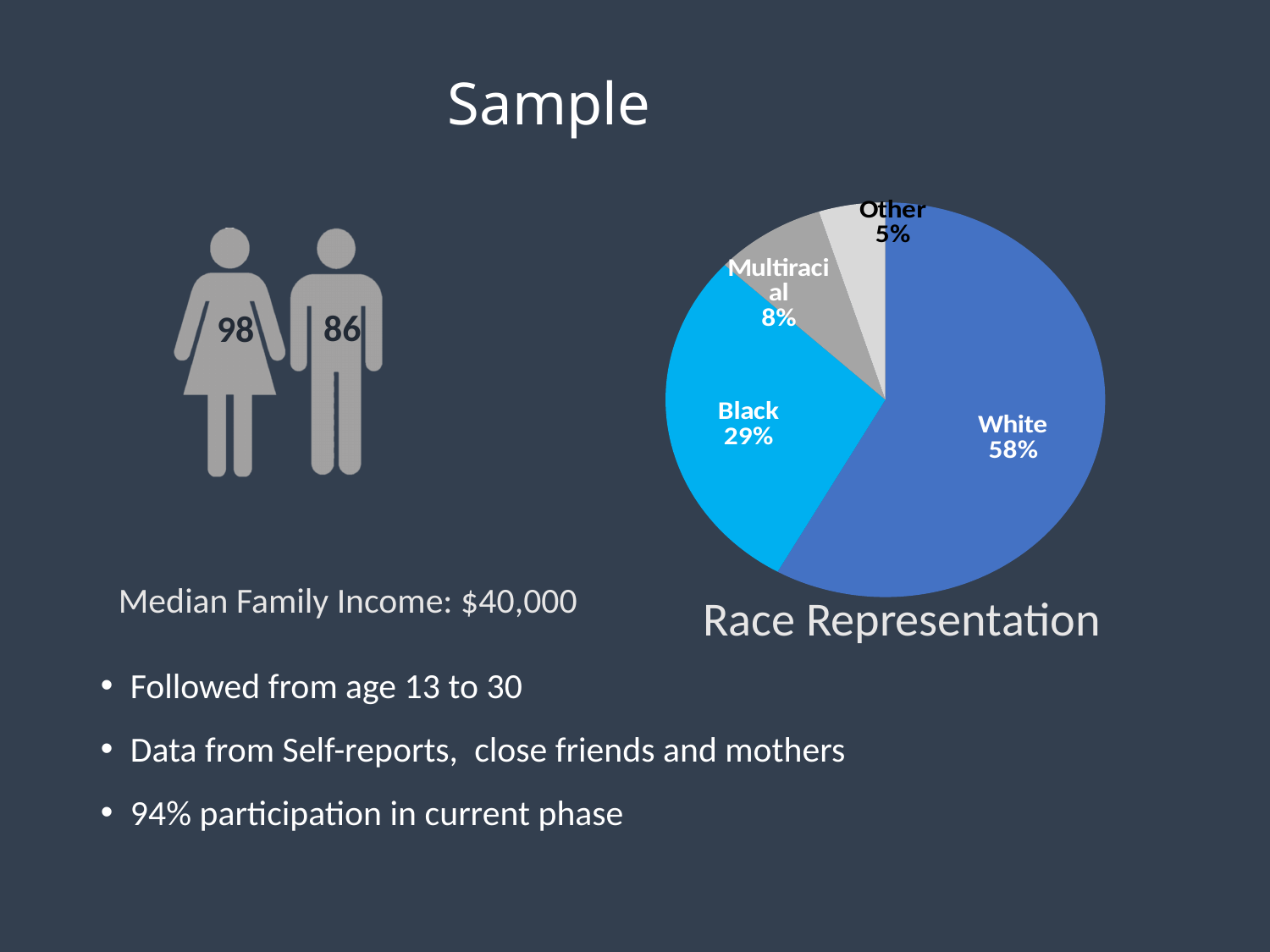
What share of the Race Representation pie is White? 58% In the Race Representation pie chart, what is the difference in percentage points between White and Black? 29 How many slices does the Race Representation pie chart have? 4 Which category has the smallest slice in the Race Representation pie chart? Other What share of the Race Representation pie is Black? 29% In the Race Representation pie chart, which is larger, Multiracial or Other? Multiracial In the Race Representation pie chart, what is the combined share of Multiracial and Other? 13% What is the title of the pie chart on the slide? Race Representation What type of chart is the Race Representation chart? pie chart Which category has the largest slice in the Race Representation pie chart? White What share of the Race Representation pie is Other? 5%